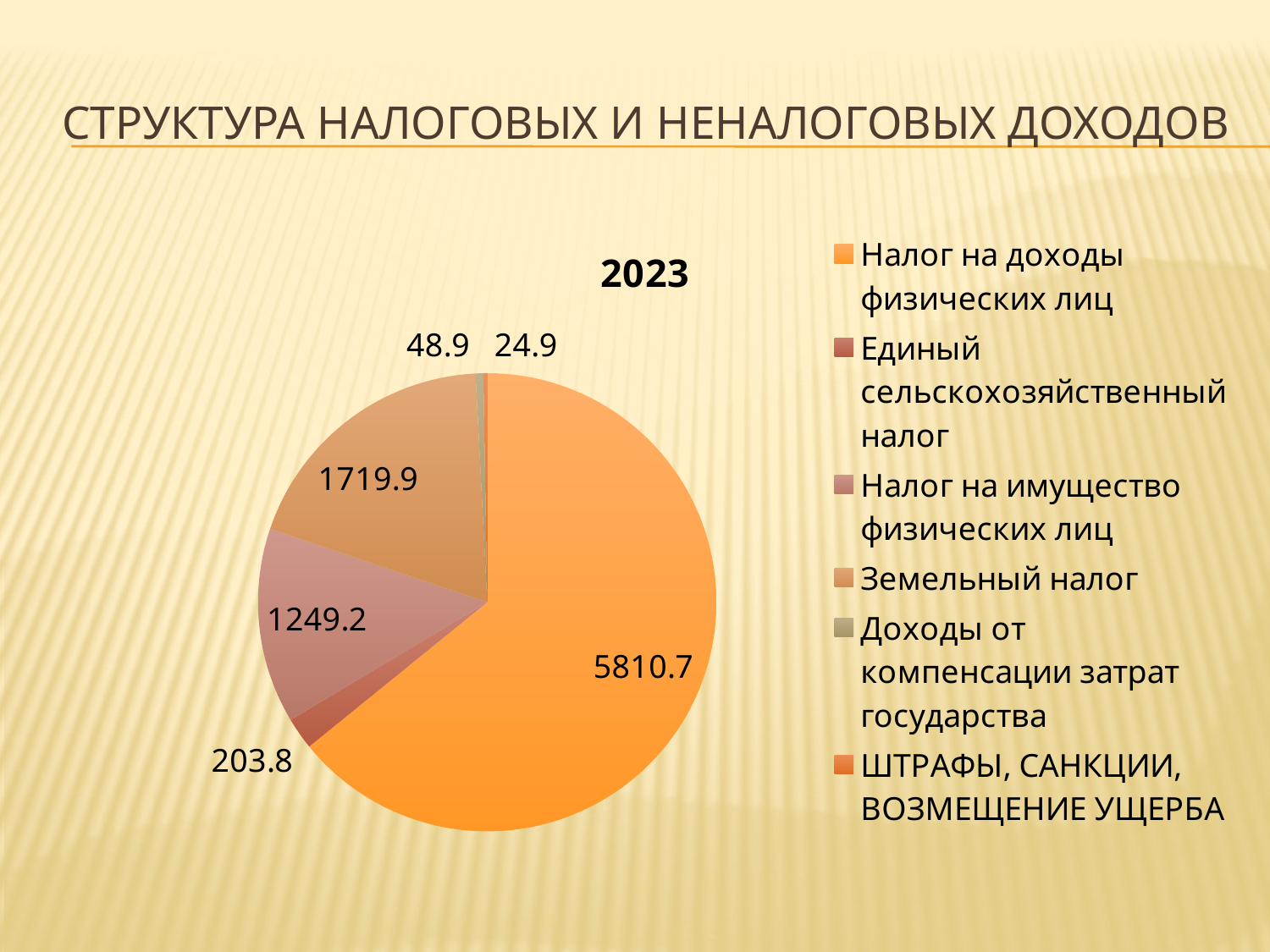
What is the value for Единый сельскохозяйственный налог in the pie chart? 203.8 Which category has the largest slice in the pie chart? Налог на доходы физических лиц What is the value for Налог на доходы физических лиц in the pie chart? 5810.7 What is the value for Налог на имущество физических лиц in the pie chart? 1249.2 What is the value for Земельный налог in the pie chart? 1719.9 What is the difference between the values for Земельный налог and Налог на имущество физических лиц? 470.7 Which is larger: the value for Земельный налог or the value for Налог на имущество физических лиц? Земельный налог How many categories does the pie chart show? 6 What is the title shown above the pie chart? 2023 What type of chart is shown on the slide? Pie chart What is the value for Доходы от компенсации затрат государства in the pie chart? 48.9 Which category has the smallest slice in the pie chart? ШТРАФЫ, САНКЦИИ, ВОЗМЕЩЕНИЕ УЩЕРБА